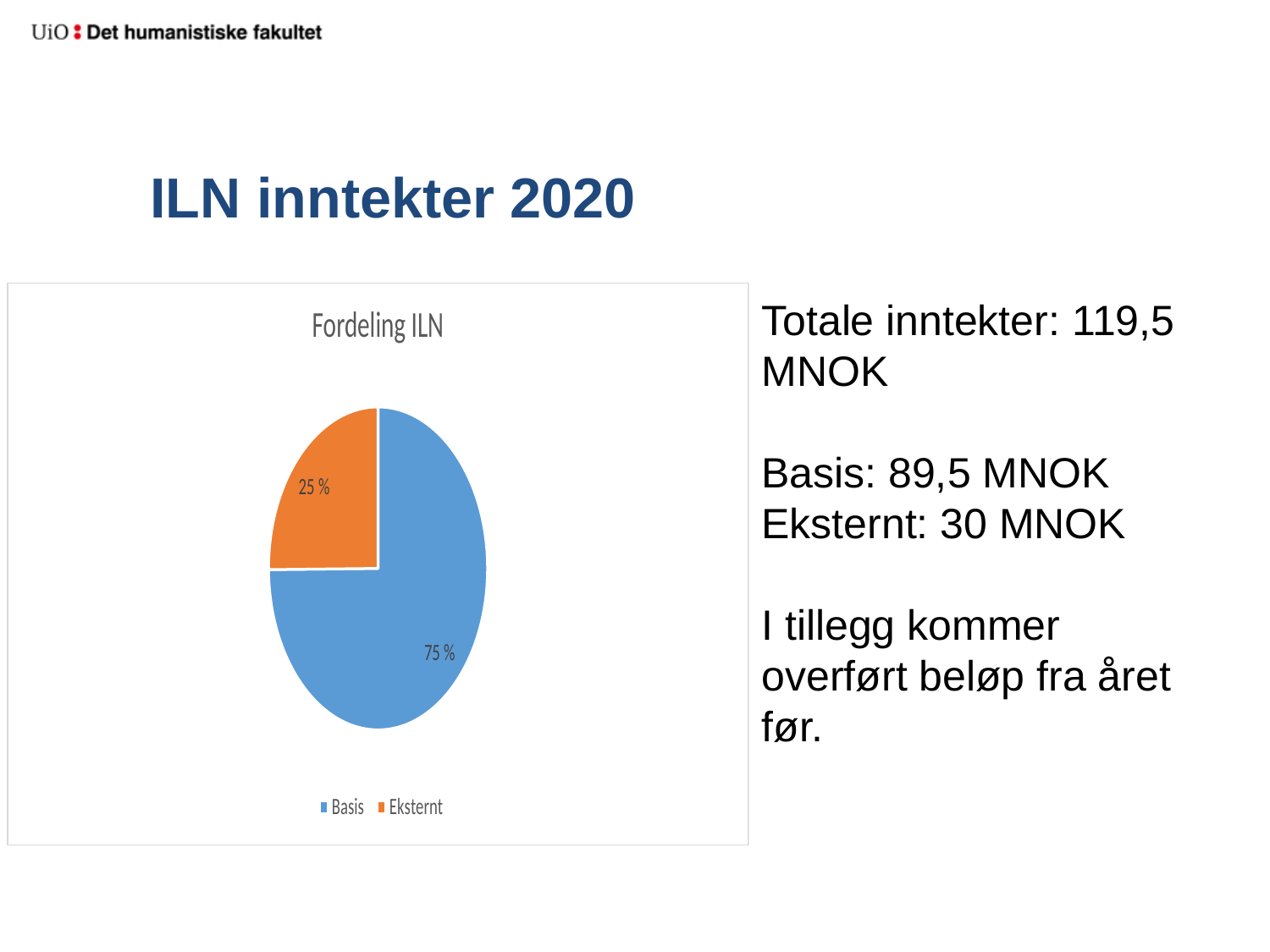
How many entries does the legend list? 2 How many slices does the pie chart have? 2 Is the share for Basis greater or less than 50 %? greater Which slice is the smallest in the pie chart? Eksternt What kind of chart is shown on the slide? pie chart What colour is the Eksternt slice? orange Which is larger, the Basis slice or the Eksternt slice? Basis What is the title of the chart? Fordeling ILN Which slice is the largest in the pie chart? Basis What share of the pie does Basis take? 75 % What share of the pie does Eksternt take? 25 % What is the difference in percentage points between the Basis and Eksternt slices? 50 percentage points